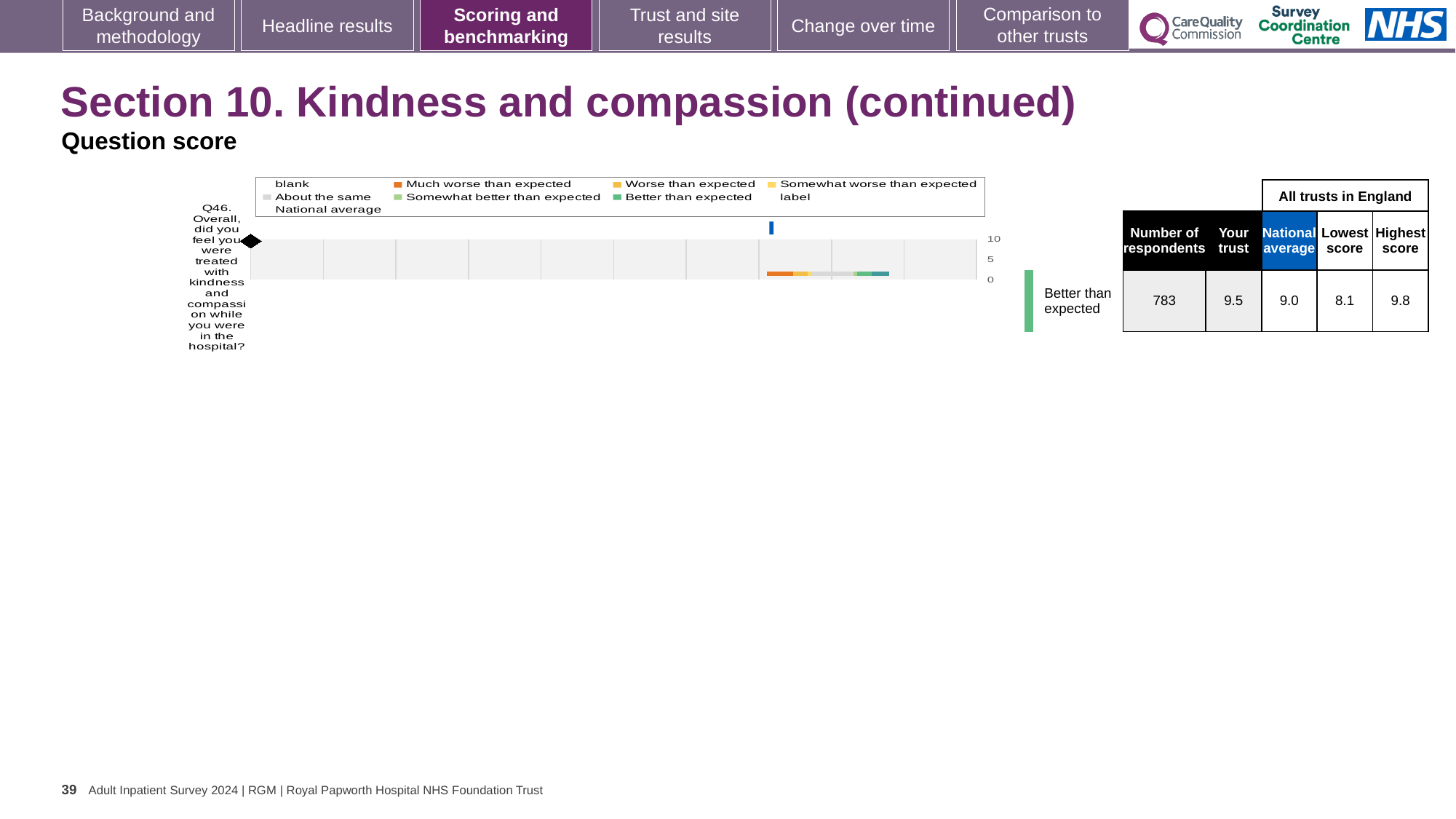
What is the highest value shown on the chart's axis? 10 What kind of chart is shown on the slide? bar chart According to the table beside the chart, what is the number of respondents for Q46? 783 According to the table beside the chart, what is the score for Your trust on Q46? 9.5 According to the table beside the chart, what is the Highest score among all trusts in England for Q46? 9.8 How many entries does the chart's legend list? 9 How many questions (categories) are plotted on the chart? 1 What is the difference between the Your trust score and the National average score for Q46? 0.5 Which is larger for Q46: the Your trust score or the National average score? Your trust According to the table beside the chart, what is the National average score for Q46? 9.0 According to the table beside the chart, what is the Lowest score among all trusts in England for Q46? 8.1 Which question number is plotted on the chart? Q46